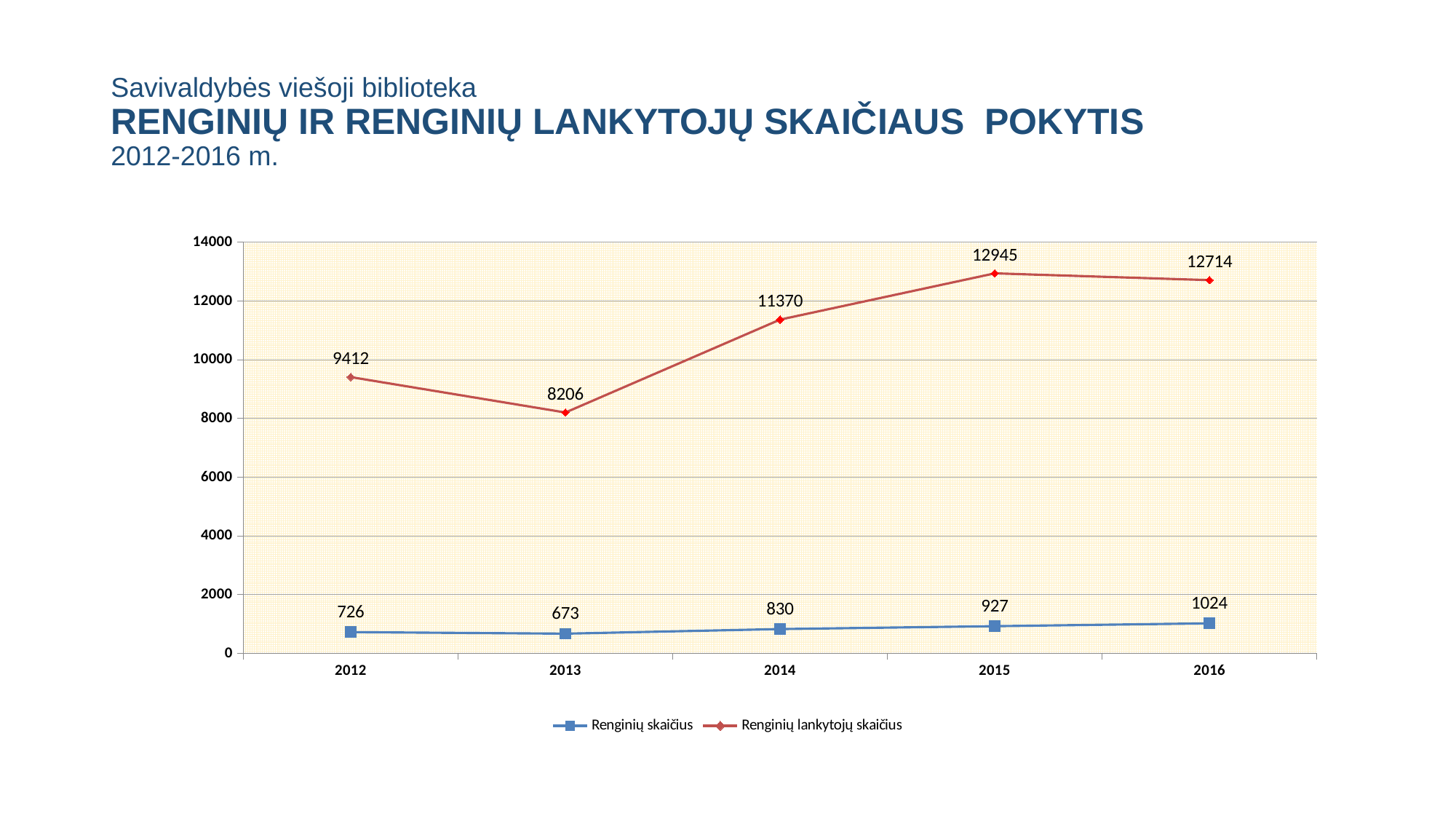
What is the value of Renginių lankytojų skaičius in 2014? 11370 Does Renginių skaičius rise or fall from 2013 to 2016? rise What kind of chart is shown on the slide? line chart In which year is Renginių lankytojų skaičius highest? 2015 Which is larger: Renginių lankytojų skaičius in 2012 or in 2014? 2014 In which year is Renginių skaičius lowest? 2013 How many series does the legend list? 2 How many years are shown on the x axis? 5 What is the difference between Renginių skaičius in 2016 and 2012? 298 What is the value of Renginių lankytojų skaičius in 2013? 8206 What is the difference between Renginių lankytojų skaičius in 2015 and 2016? 231 What is the value of Renginių skaičius in 2016? 1024